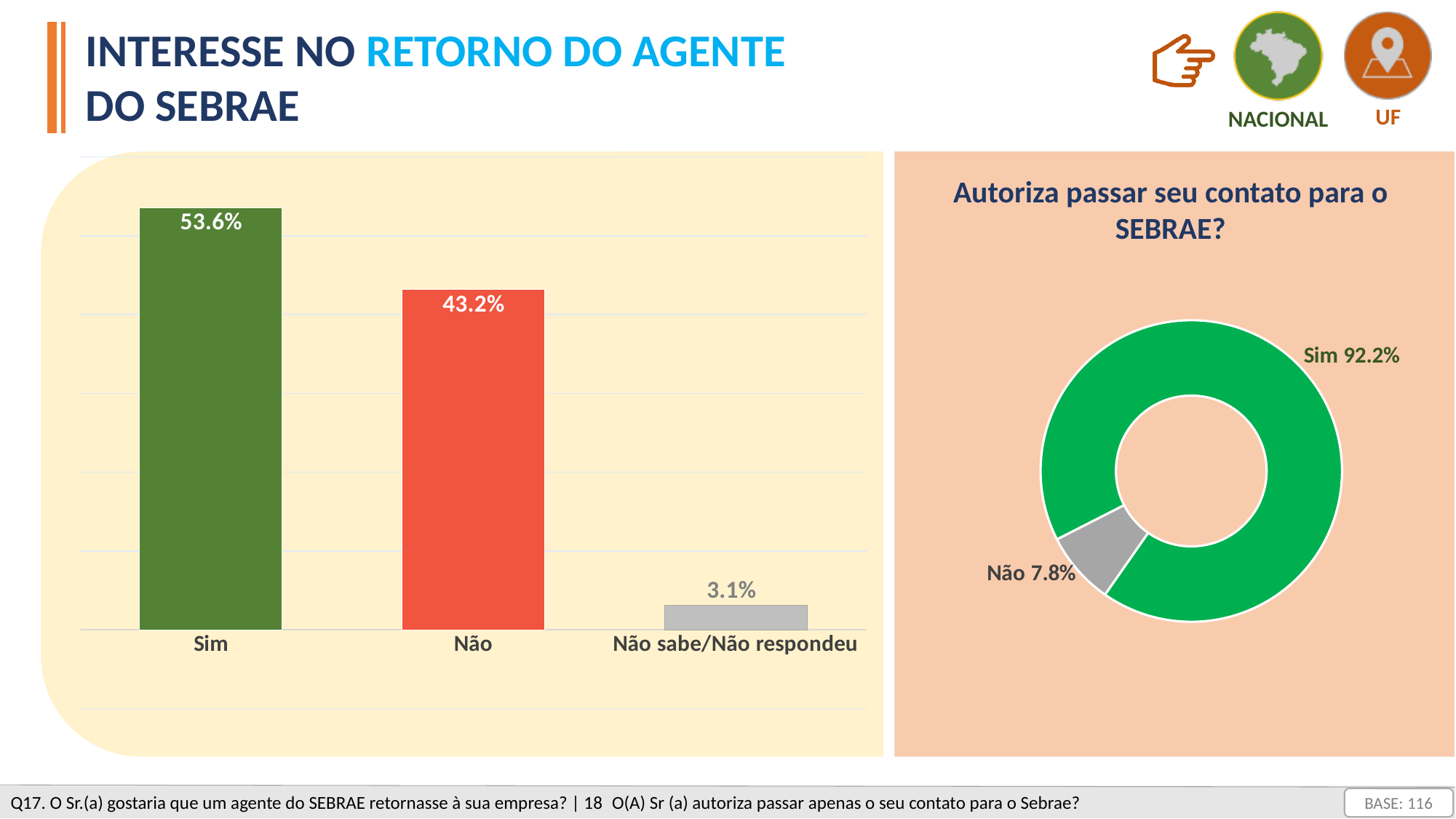
In the bar chart on the left, what is the value for Não? 43.2% In the bar chart on the left, which category has the highest value? Sim In the chart titled 'Autoriza passar seu contato para o SEBRAE?', which slice is larger, Sim or Não? Sim What kind of chart is shown on the left side of the slide? Bar chart In the bar chart on the left, what is the value for Não sabe/Não respondeu? 3.1% What kind of chart is shown on the right side of the slide? Doughnut (pie) chart In the chart titled 'Autoriza passar seu contato para o SEBRAE?', what is the value for Sim? 92.2% In the bar chart on the left, which category has the lowest value? Não sabe/Não respondeu In the bar chart on the left, what is the difference between the values for Sim and Não? 10.4% In the chart titled 'Autoriza passar seu contato para o SEBRAE?', what is the value for Não? 7.8% In the bar chart on the left, how many categories are shown? 3 In the bar chart on the left, what is the value for Sim? 53.6%